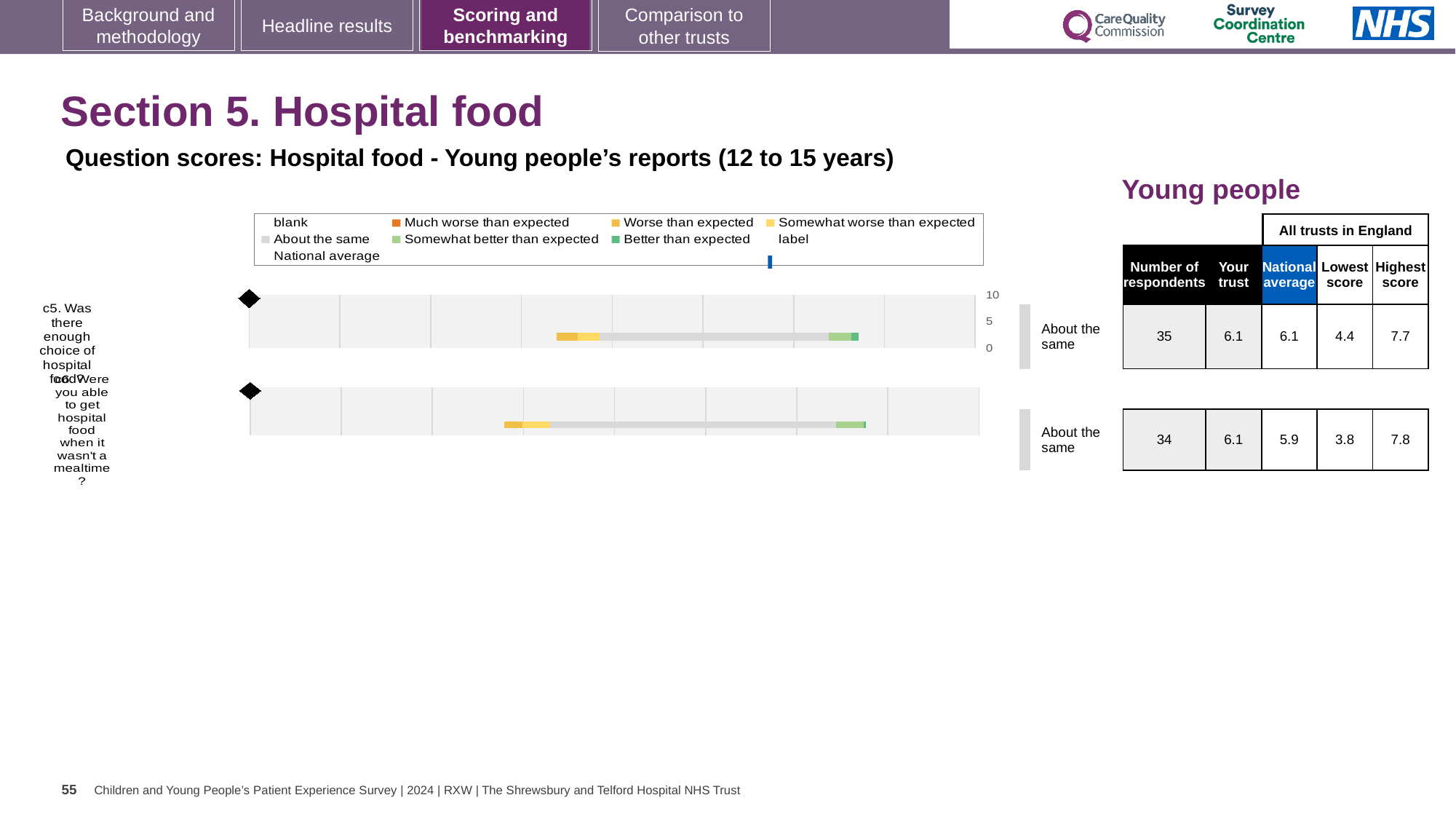
How many respondents answered question c6 (Were you able to get hospital food when it wasn't a mealtime?)? 34 What is the 'Your trust' score for question c5? 6.1 What kind of chart is used to show the question scores for hospital food? bar chart Which question has the larger lowest score across all trusts in England, c5 or c6? c5 What is the difference between the highest score and the lowest score for question c5? 3.3 What is the maximum value shown on the chart's score axis? 10 Which colour in the legend represents 'Much worse than expected'? orange How many questions (bars) are plotted in the hospital food chart? 2 How many respondents answered question c5 (Was there enough choice of hospital food?)? 35 What is the national average score for question c6? 5.9 What is the highest score across all trusts in England for question c6? 7.8 What is the lowest score across all trusts in England for question c5? 4.4